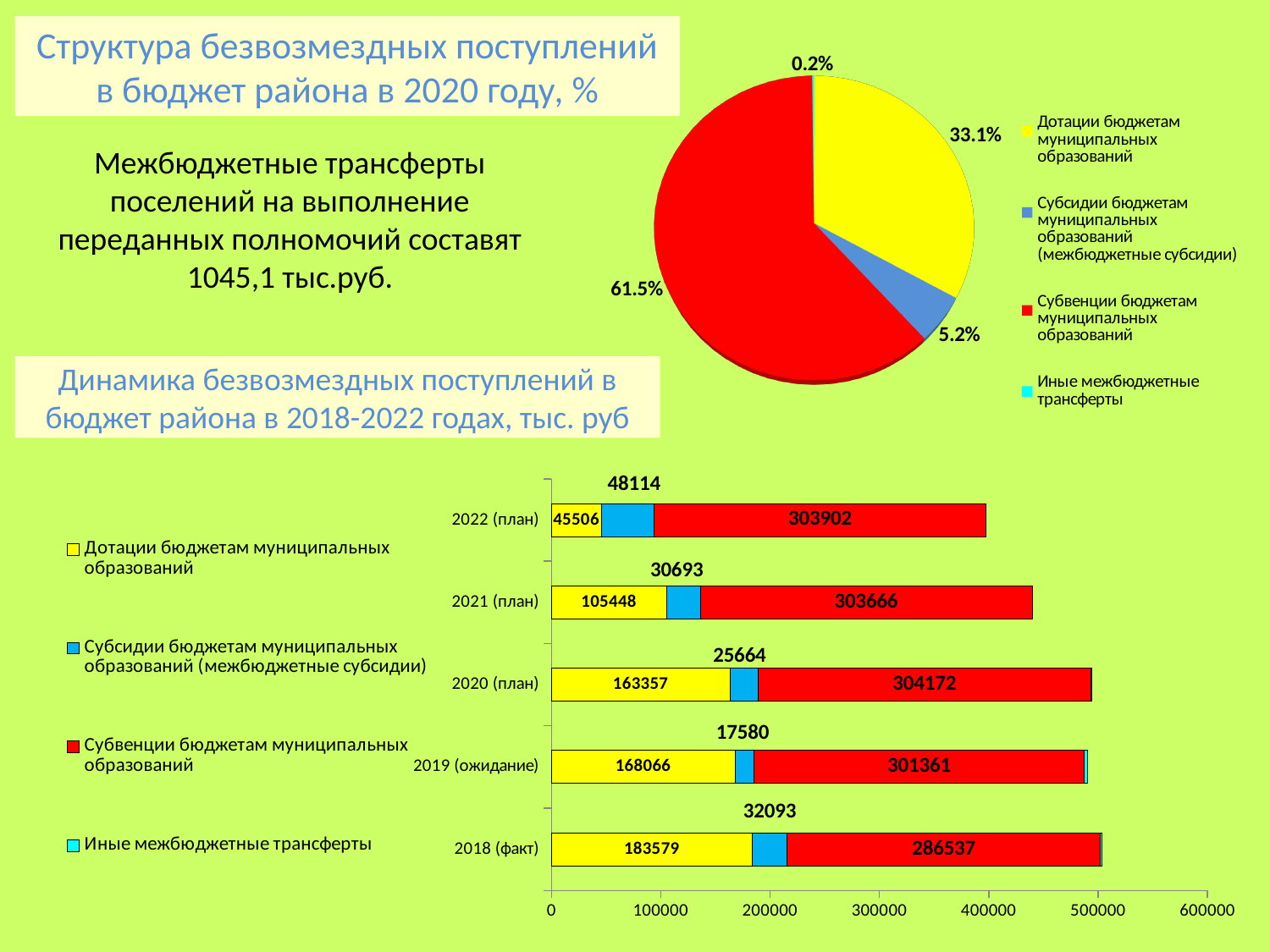
In the pie chart 'Структура безвозмездных поступлений в бюджет района в 2020 году, %', what share is shown for 'Дотации бюджетам муниципальных образований'? 33.1% In the bar chart 'Динамика безвозмездных поступлений в бюджет района в 2018-2022 годах, тыс. руб', what is the value of 'Дотации бюджетам муниципальных образований' for 2018 (факт)? 183579 In the bar chart 'Динамика безвозмездных поступлений в бюджет района в 2018-2022 годах, тыс. руб', is the 'Субсидии' value larger for 2021 (план) or for 2019 (ожидание)? 2021 (план) In the pie chart 'Структура безвозмездных поступлений в бюджет района в 2020 году, %', which category has the smallest slice? Иные межбюджетные трансферты How many series does the legend of the bar chart 'Динамика безвозмездных поступлений в бюджет района в 2018-2022 годах, тыс. руб' list? 4 In the pie chart 'Структура безвозмездных поступлений в бюджет района в 2020 году, %', what share is shown for 'Субвенции бюджетам муниципальных образований'? 61.5% In the bar chart 'Динамика безвозмездных поступлений в бюджет района в 2018-2022 годах, тыс. руб', which year has the lowest value for 'Дотации бюджетам муниципальных образований'? 2022 (план) In the bar chart 'Динамика безвозмездных поступлений в бюджет района в 2018-2022 годах, тыс. руб', what is the value of 'Субвенции бюджетам муниципальных образований' for 2020 (план)? 304172 In the bar chart 'Динамика безвозмездных поступлений в бюджет района в 2018-2022 годах, тыс. руб', what is the value of 'Субсидии бюджетам муниципальных образований (межбюджетные субсидии)' for 2022 (план)? 48114 How many slices does the pie chart 'Структура безвозмездных поступлений в бюджет района в 2020 году, %' have? 4 What kind of chart is the chart 'Динамика безвозмездных поступлений в бюджет района в 2018-2022 годах, тыс. руб'? Stacked bar chart In the bar chart 'Динамика безвозмездных поступлений в бюджет района в 2018-2022 годах, тыс. руб', what is the difference between the 'Дотации бюджетам муниципальных образований' values for 2018 (факт) and 2022 (план)? 138073